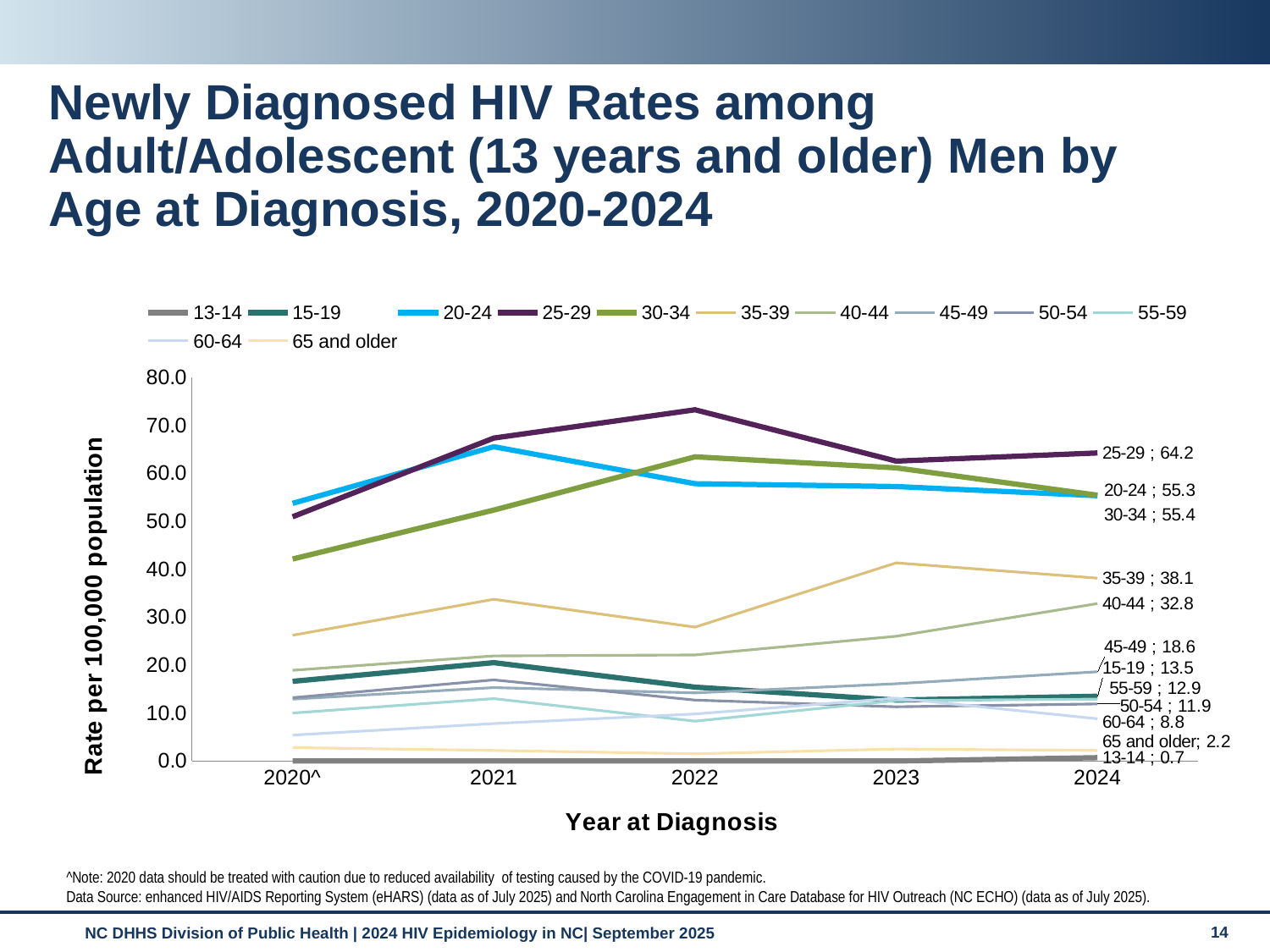
How many years are shown on the x axis? 5 Is the rate for the 30-34 age group in 2020 greater or less than 50.0? less What is the rate for the 65 and older age group in 2024? 2.2 Which age group has the highest rate in 2024? 25-29 How many age groups does the legend list? 12 What is the rate for the 35-39 age group in 2024? 38.1 In 2024, which age group has the higher rate: 35-39 or 40-44? 35-39 What is the difference between the 2024 rates for the 25-29 and 20-24 age groups? 8.9 Is the rate for the 25-29 age group in 2022 greater or less than 70.0? greater What is the rate for the 25-29 age group in 2024? 64.2 Which age group has the lowest rate in 2024? 13-14 What kind of chart is shown on the slide? Line chart